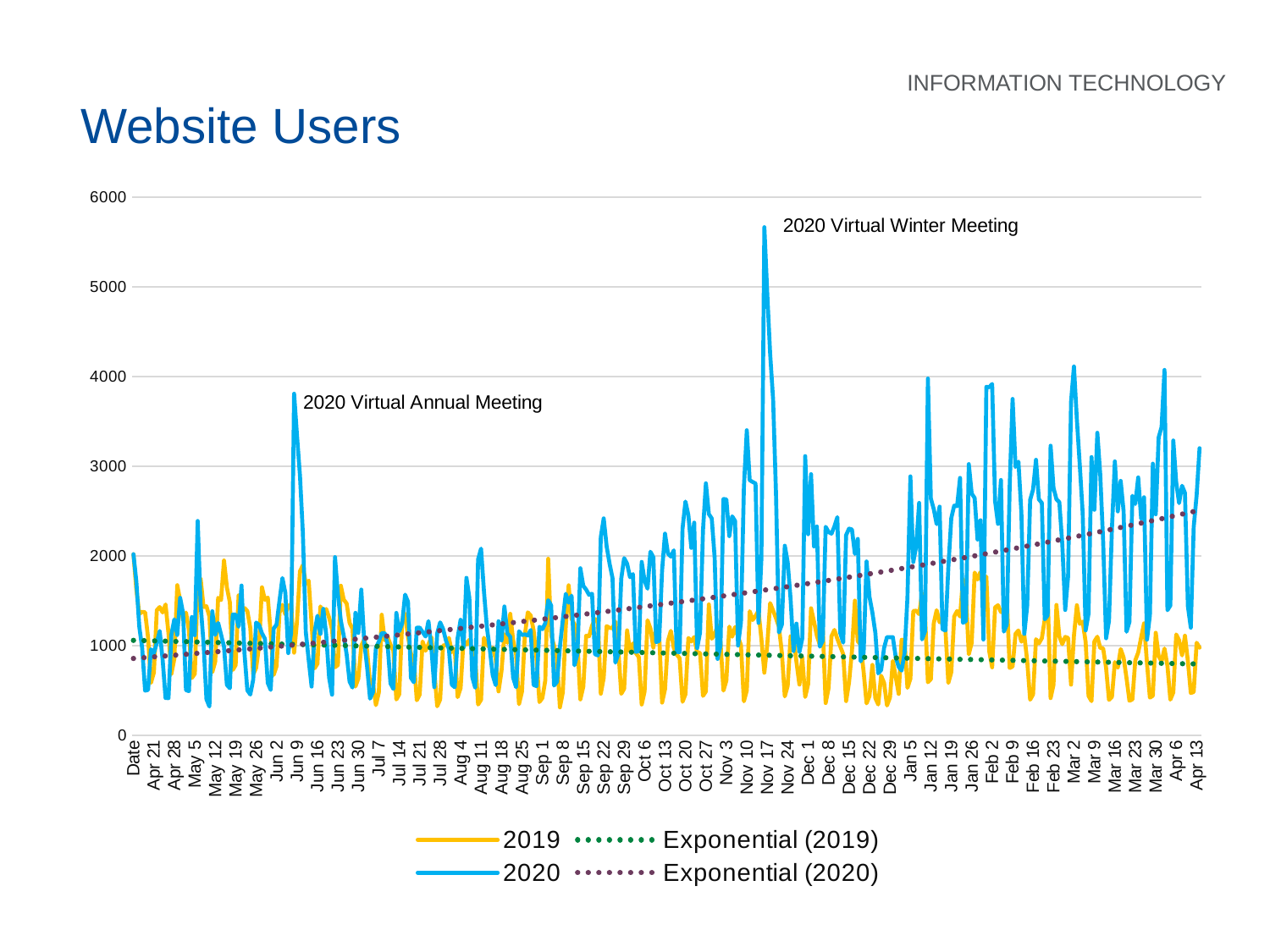
What is the title of the chart on the slide? Website Users At Mar 2, which series has the higher value, 2019 or 2020? 2020 Is the 2019 value at Nov 17 greater or less than 2000? less Which series reaches the highest value on the chart, 2019 or 2020? 2020 What event label is attached to the 2020 peak around Nov 17? 2020 Virtual Winter Meeting Does the Exponential (2019) trendline rise or fall from left to right? falls What is the highest value shown on the vertical axis? 6000 What kind of chart is shown on the slide? line chart Does the Exponential (2020) trendline rise or fall from left to right? rises How many entries does the chart legend list? 4 Is the 2020 value at Jun 9 greater or less than 3000? greater